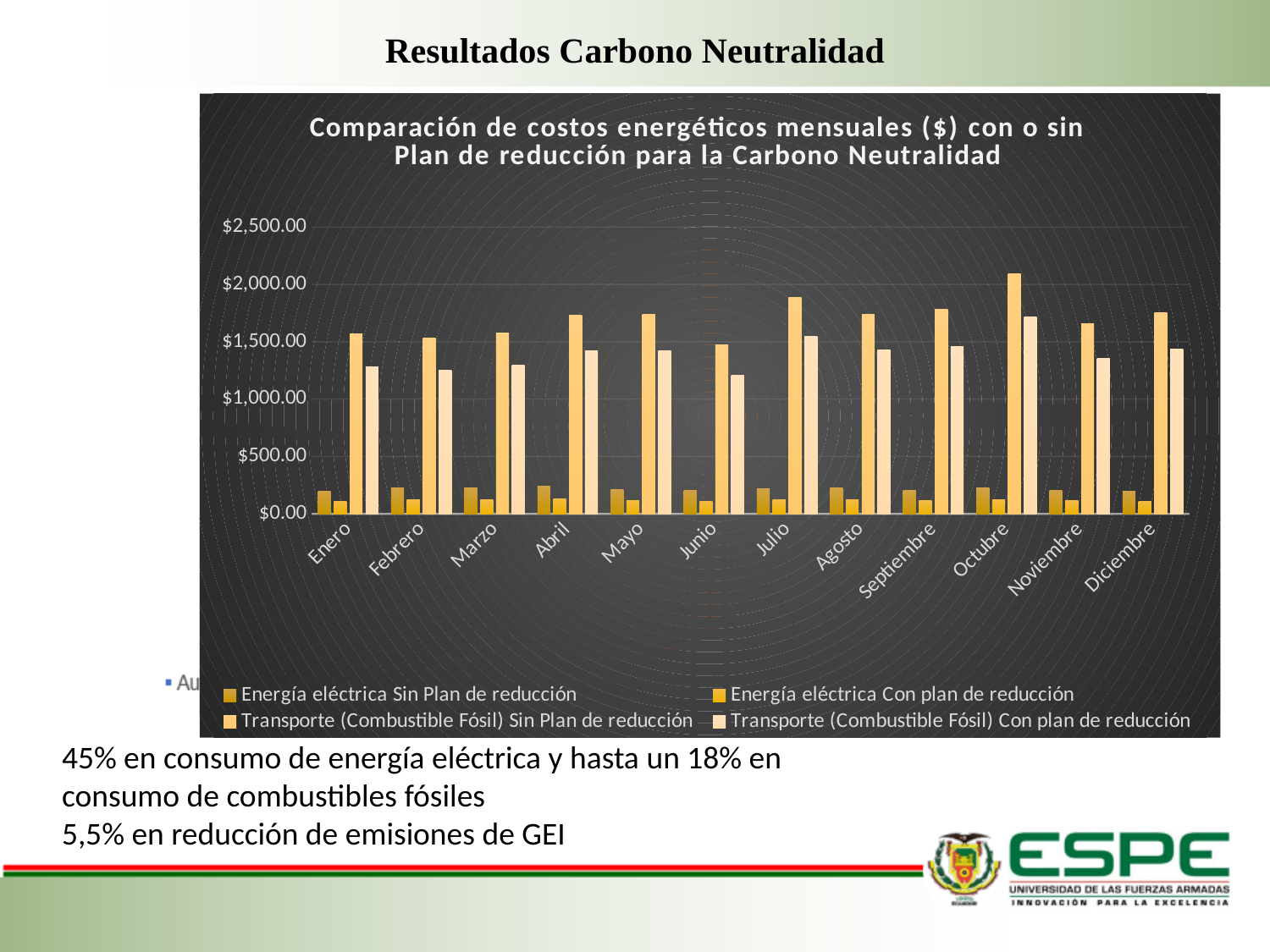
In which month is the value for Transporte (Combustible Fósil) Con plan de reducción highest? Octubre Is the value for Energía eléctrica Sin Plan de reducción in Abril greater or less than $500.00? less What kind of chart is shown on the slide? Bar chart In Octubre, which is larger: Transporte (Combustible Fósil) Sin Plan de reducción or Transporte (Combustible Fósil) Con plan de reducción? Transporte (Combustible Fósil) Sin Plan de reducción In which month is the value for Transporte (Combustible Fósil) Sin Plan de reducción highest? Octubre What is the title of the chart? Comparación de costos energéticos mensuales ($) con o sin Plan de reducción para la Carbono Neutralidad Is the value for Transporte (Combustible Fósil) Sin Plan de reducción in Octubre greater or less than $2,000.00? greater Is the value for Transporte (Combustible Fósil) Con plan de reducción in Enero greater or less than $1,000.00? greater How many series does the chart legend list? 4 In Enero, which is larger: Energía eléctrica Sin Plan de reducción or Energía eléctrica Con plan de reducción? Energía eléctrica Sin Plan de reducción How many months are shown on the x axis of the chart? 12